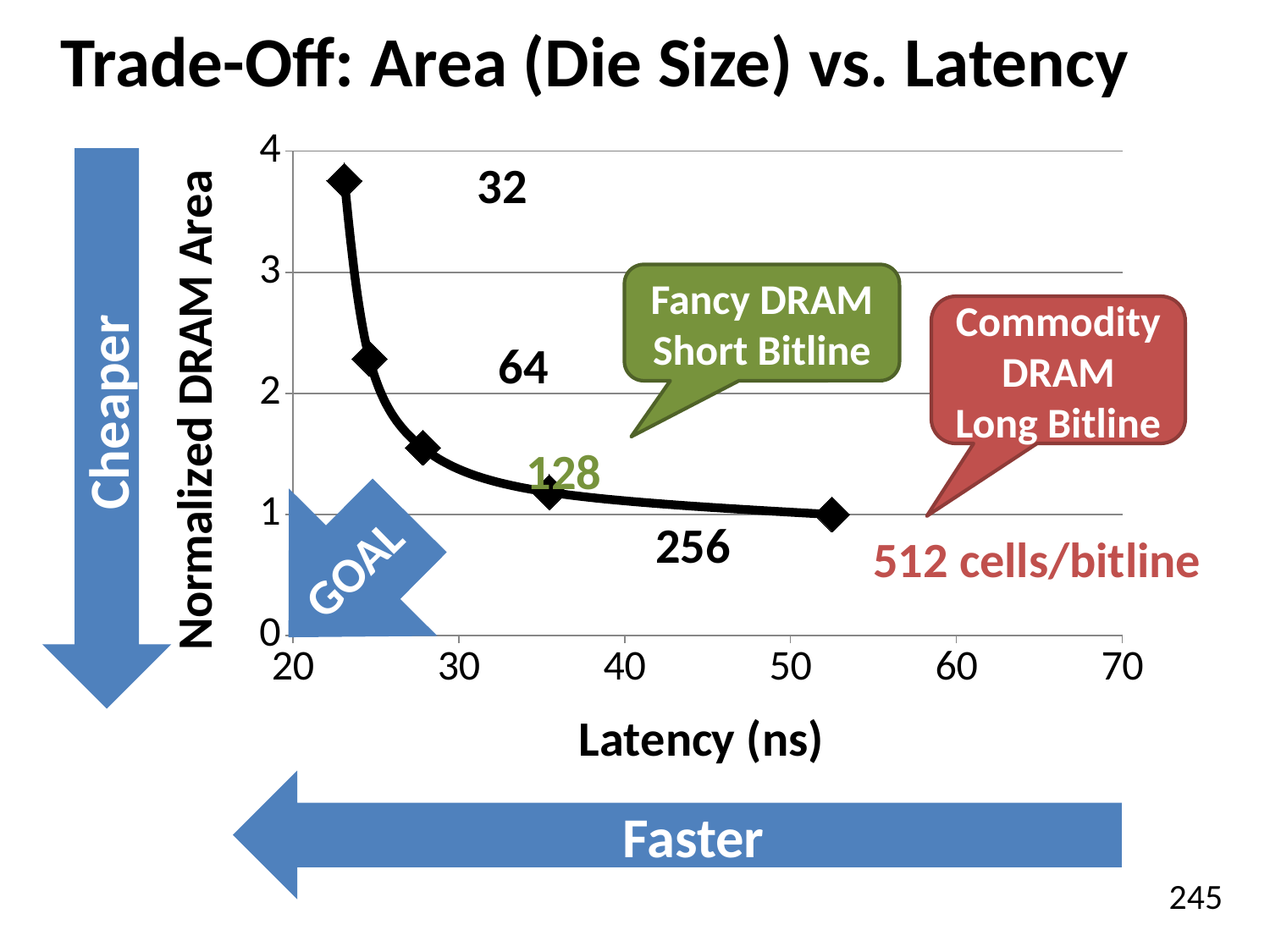
What is the label of the x axis? Latency (ns) Is the normalized DRAM area for the 128 point greater or less than 2? less Which labeled point has the lowest normalized DRAM area? 512 cells/bitline Which labeled point has the highest normalized DRAM area? 32 Is the latency for the 512 cells/bitline point greater or less than 50? greater How many data points are plotted on the chart? 5 Is the normalized DRAM area for the 64 point greater or less than 2? greater What kind of chart is shown on the slide? line chart As latency increases along the x axis, does the normalized DRAM area rise or fall? fall What is the normalized DRAM area of the 512 cells/bitline point? 1 Which has a larger normalized DRAM area, the 32 point or the 64 point? 32